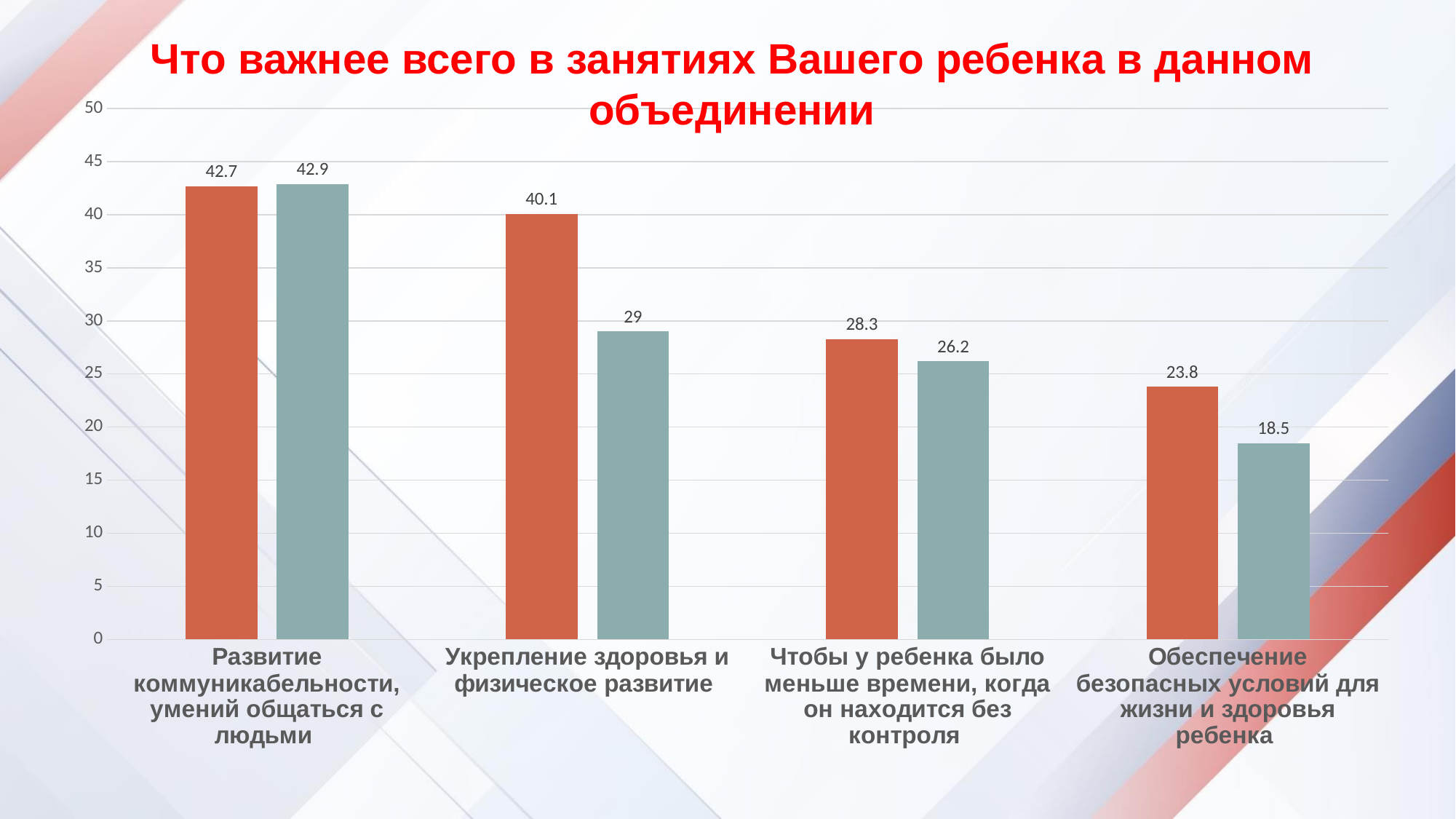
What is the value of the orange bar for "Чтобы у ребенка было меньше времени, когда он находится без контроля"? 28.3 What type of chart is shown on the slide? bar chart What is the value of the grey bar for "Укрепление здоровья и физическое развитие"? 29 What is the value of the orange bar for "Развитие коммуникабельности, умений общаться с людьми"? 42.7 Which is larger for "Обеспечение безопасных условий для жизни и здоровья ребенка": the orange bar or the grey bar? the orange bar What is the difference between the orange and grey bars for "Укрепление здоровья и физическое развитие"? 11.1 What is the value of the grey bar for "Обеспечение безопасных условий для жизни и здоровья ребенка"? 18.5 Which category has the lowest grey bar? Обеспечение безопасных условий для жизни и здоровья ребенка How many categories are shown on the x axis of the chart? 4 Which category has the highest orange bar? Развитие коммуникабельности, умений общаться с людьми What is the title of the chart? Что важнее всего в занятиях Вашего ребенка в данном объединении Do the orange bar values rise or fall from left to right across the categories? fall